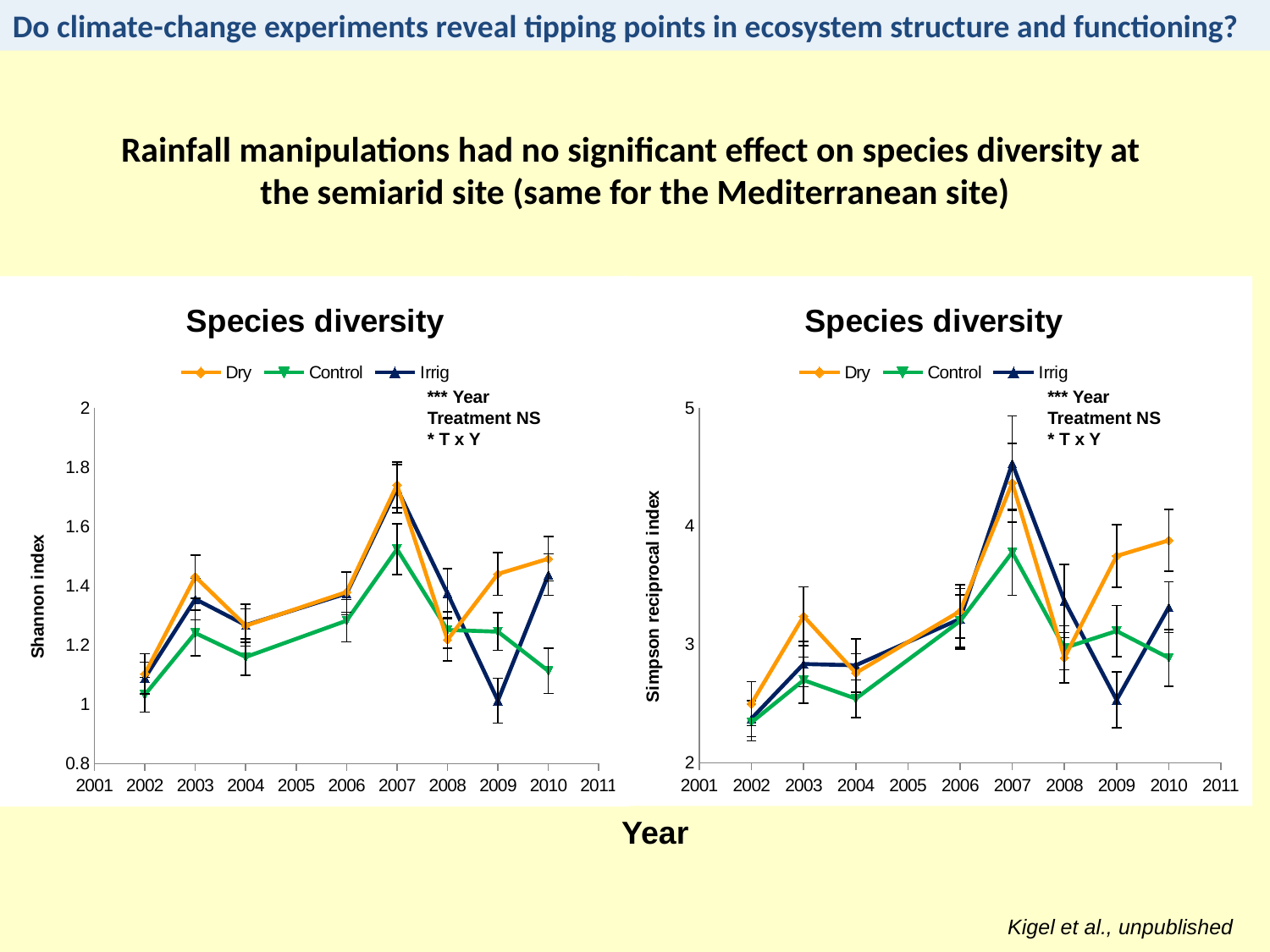
In the left chart (Shannon index), which is higher in 2010, Dry or Control? Dry What kind of chart is the left chart (Shannon index)? Line chart In the right chart (Simpson reciprocal index), which is higher in 2009, Dry or Irrig? Dry In the left chart (Shannon index), is the Dry value for 2007 greater or less than 1.6? greater In the right chart (Simpson reciprocal index), is the Dry value for 2007 greater or less than 4? greater In the right chart (Simpson reciprocal index), which series has the lowest value in 2007? Control In the left chart (Shannon index), how many years have plotted data points for the Dry series? 8 In the right chart (Simpson reciprocal index), is the Irrig value for 2009 greater or less than 3? less In the left chart (Shannon index), in which year does the Dry series reach its highest value? 2007 What is the y-axis label of the right chart? Simpson reciprocal index How many series does the legend of the right chart (Simpson reciprocal index) list? 3